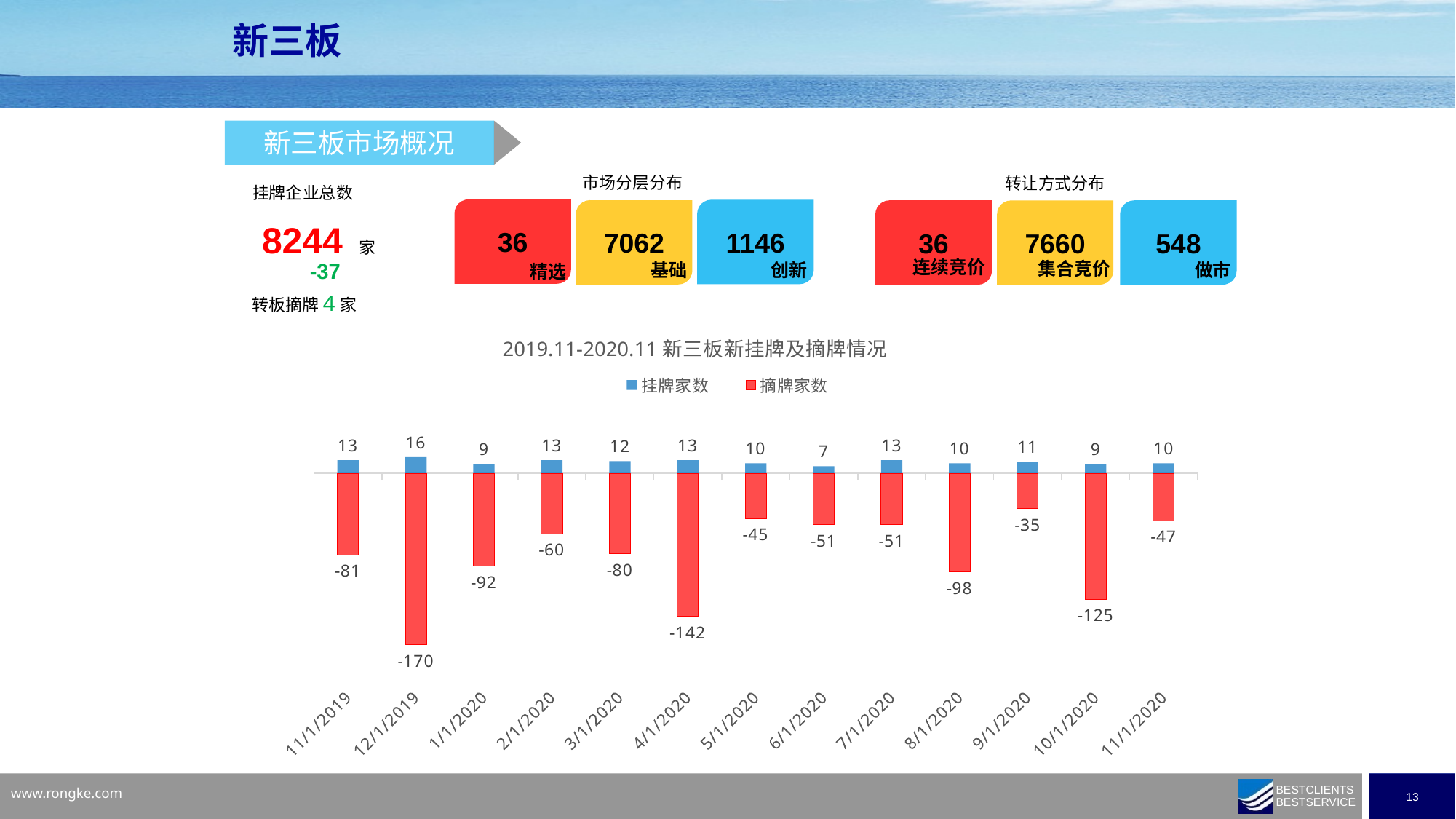
What is the 挂牌家数 value for 12/1/2019? 16 What is the 摘牌家数 value for 4/1/2020? -142 How many series does the chart legend list? 2 Which is larger in magnitude, the 摘牌家数 for 10/1/2020 or for 8/1/2020? 10/1/2020 How many months are shown on the x axis of the chart? 13 What is the 摘牌家数 value for 9/1/2020? -35 What is the difference between the 挂牌家数 for 12/1/2019 and for 6/1/2020? 9 Which month has the highest 挂牌家数? 12/1/2019 What kind of chart is used to show 新挂牌及摘牌情况? Bar chart Which month has the lowest 挂牌家数? 6/1/2020 Which month has the lowest 摘牌家数 value (the largest number of delistings)? 12/1/2019 What colour represents 摘牌家数 in the chart? Red